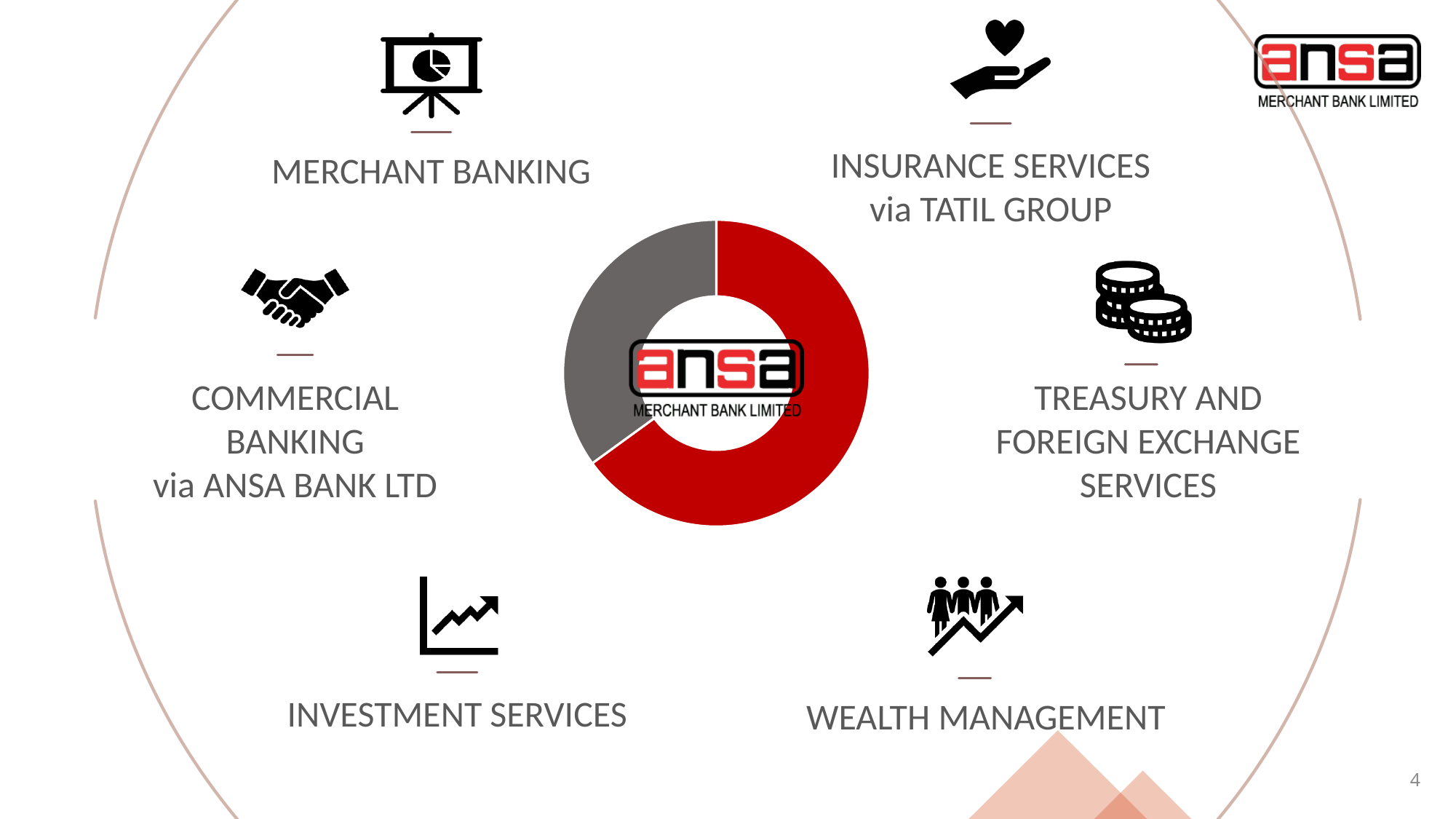
What kind of chart is shown in the centre of the slide? doughnut chart In the doughnut chart in the centre of the slide, which colour is the smaller slice? grey What two colours are used for the slices of the doughnut chart in the centre of the slide? red and grey How many slices does the doughnut chart in the centre of the slide have? 2 Does the doughnut chart in the centre of the slide show a legend? No In the doughnut chart in the centre of the slide, which slice is larger, the red one or the grey one? the red one